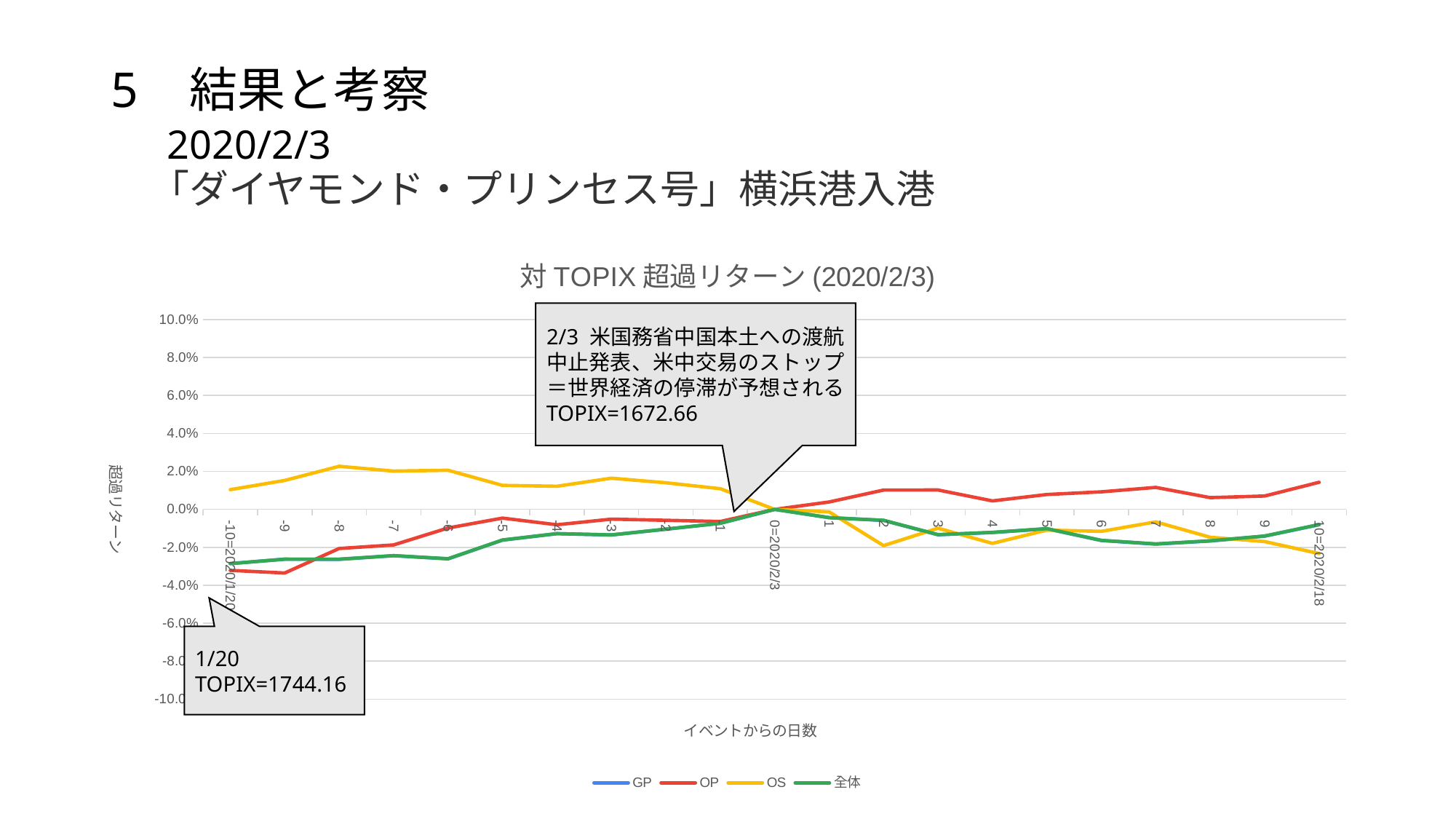
Is the value of the OS series at day 10 greater or less than 0.0%? less At day 10, which series has the higher value, OP or OS? OP According to the callout on the chart, what was the TOPIX value on 1/20? 1744.16 Is the value of the OS series at day -8 greater or less than 1.0%? greater Which series has the lowest value at day -9? OP What kind of chart is shown on the slide? line chart How many series does the legend list? 4 Is the value of the OP series at day -9 greater or less than -2.0%? less How many points are plotted along the x axis (from -10 to 10)? 21 Does the OP series rise or fall overall from day -10 to day 10? rise What is the title of the chart? 対 TOPIX 超過リターン (2020/2/3) At day -10, which series has the higher value, OP or OS? OS